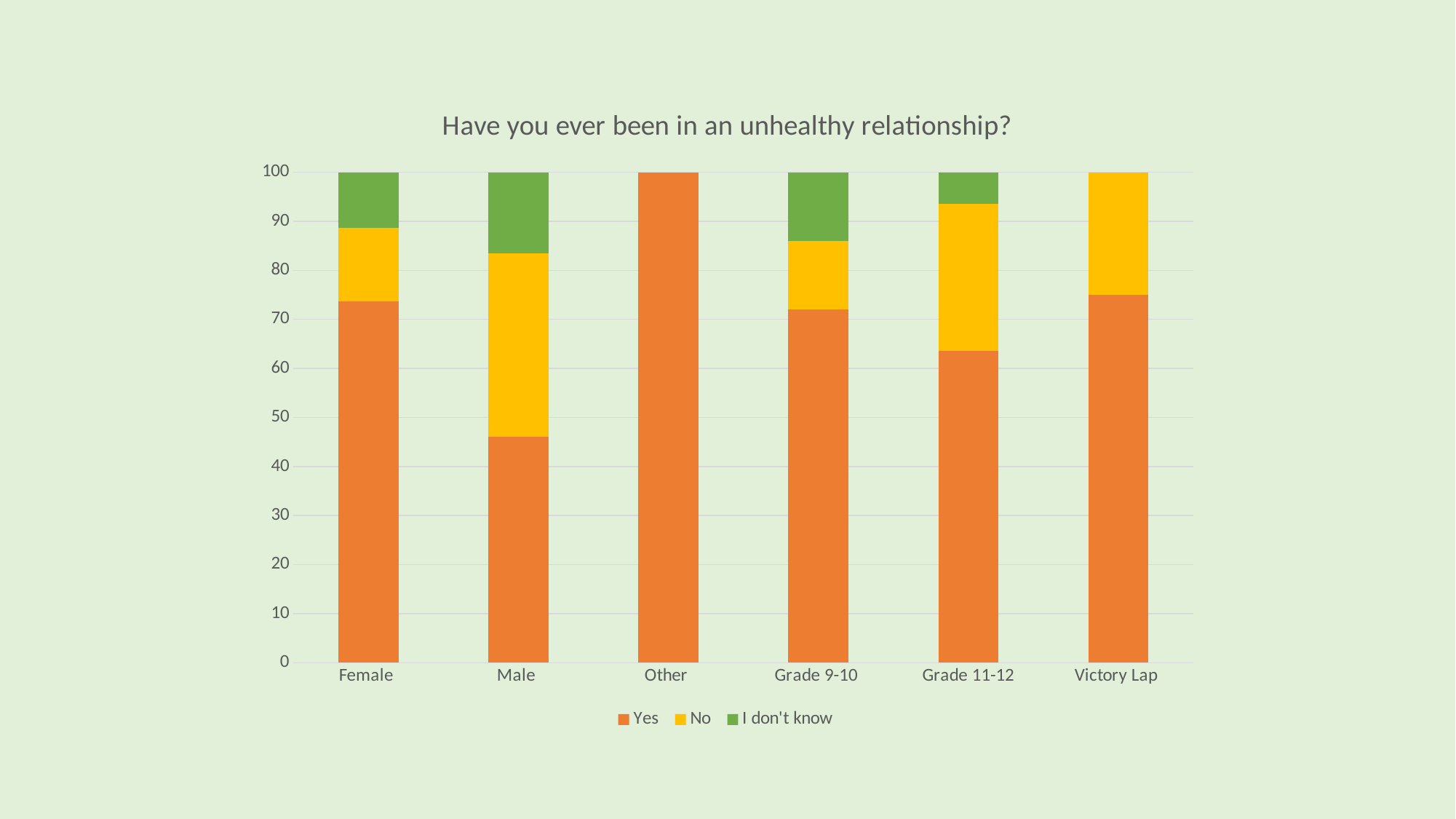
Is the Yes value for Male greater or less than 50? less Is the Yes value for Female greater or less than 70? greater Is the Yes value for Grade 11-12 greater or less than 60? greater How many categories are shown on the x axis? 6 What is the value of the Yes series for Other? 100 Which is larger, the Yes value for Female or the Yes value for Male? Female What kind of chart is shown on the slide? Bar chart How many series does the legend list? 3 Which category has the lowest value for the Yes series? Male Which category has the highest value for the Yes series? Other What is the title of the chart? Have you ever been in an unhealthy relationship? What is the total of the stacked bar for Victory Lap? 100